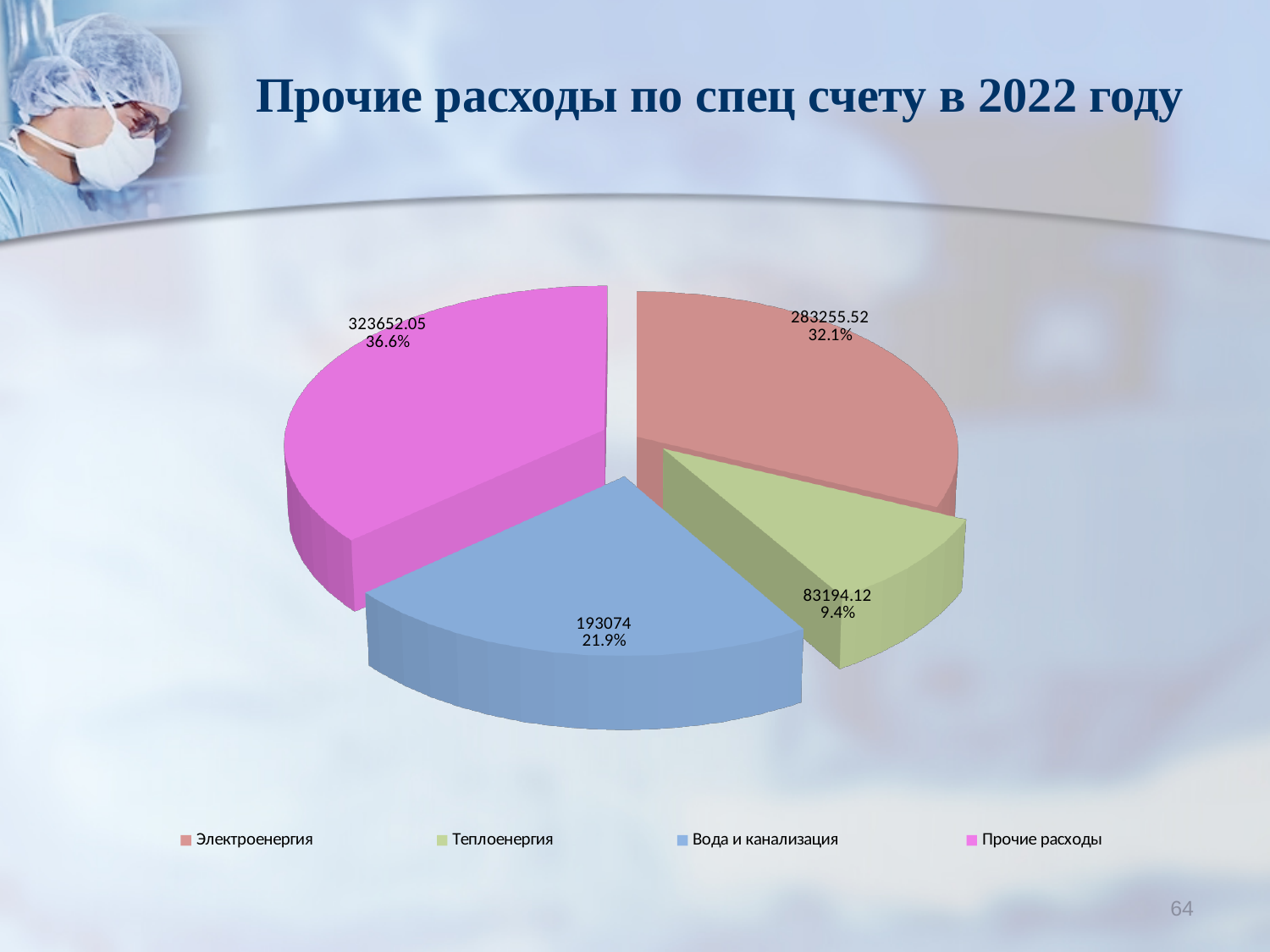
What share of the pie does Прочие расходы take? 36.6% Which category has the smallest slice? Теплоэнергия Which category has the largest slice? Прочие расходы What is the difference between the values for Прочие расходы and Электроэнергия? 40396.53 What is the value for Вода и канализация? 193074 What is the value for Электроэнергия? 283255.52 What kind of chart is shown on the slide? pie chart What share of the pie does Теплоэнергия take? 9.4% What is the value for Прочие расходы? 323652.05 How many categories does the pie chart have? 4 What is the value for Теплоэнергия? 83194.12 Which is larger, the value for Вода и канализация or the value for Теплоэнергия? Вода и канализация